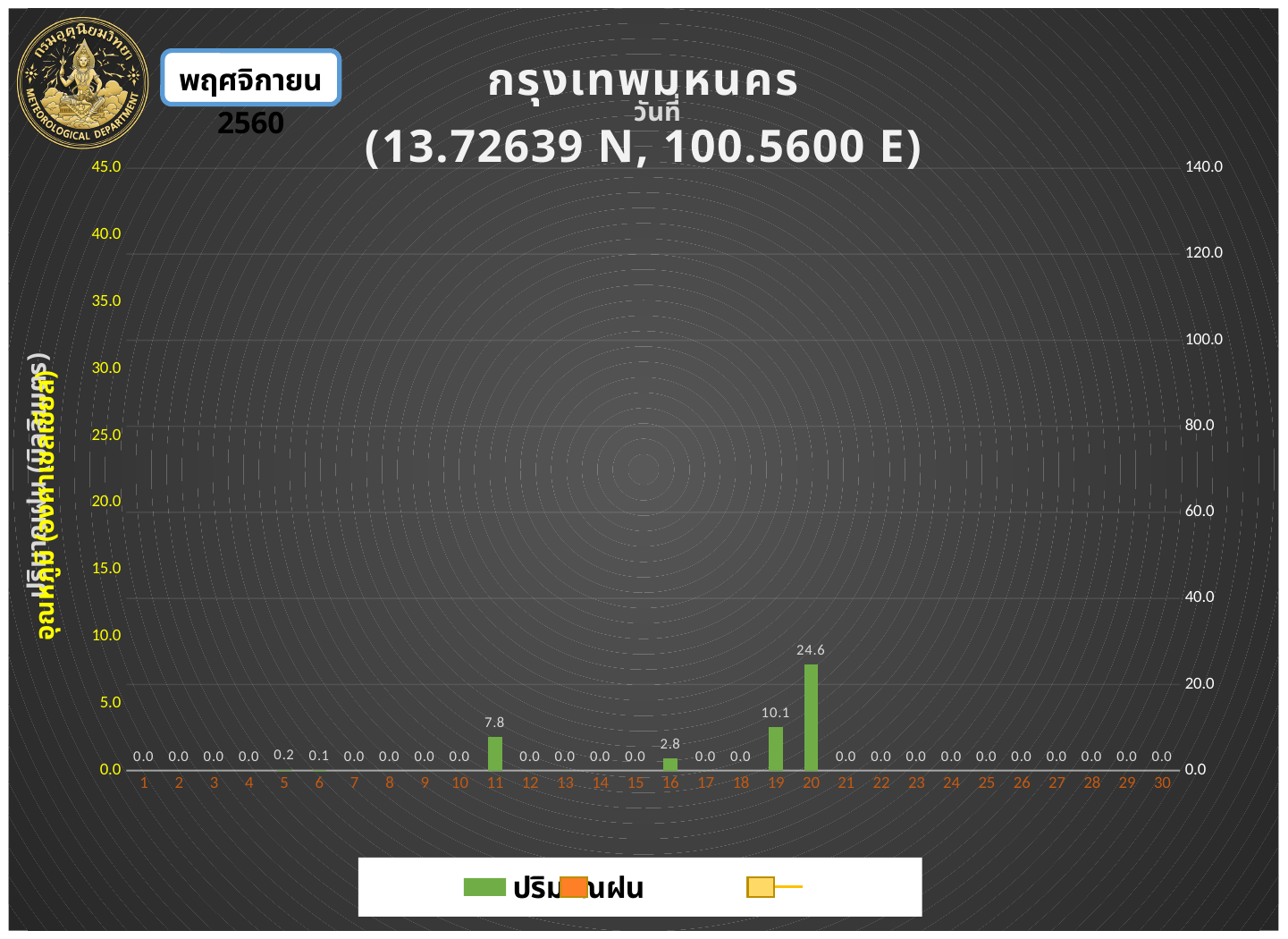
Which day has the highest rainfall value? 20 What kind of chart is shown on the slide? Bar chart What is the rainfall value shown for day 5? 0.2 What is the rainfall value shown for day 16? 2.8 What is the rainfall value shown for day 19? 10.1 What is the difference between the rainfall values for day 20 and day 19? 14.5 How many days are shown on the x axis? 30 What is the rainfall value shown for day 20? 24.6 Which has a larger rainfall value, day 11 or day 16? Day 11 What is the rainfall value shown for day 11? 7.8 What is the highest value shown on the left vertical axis? 45.0